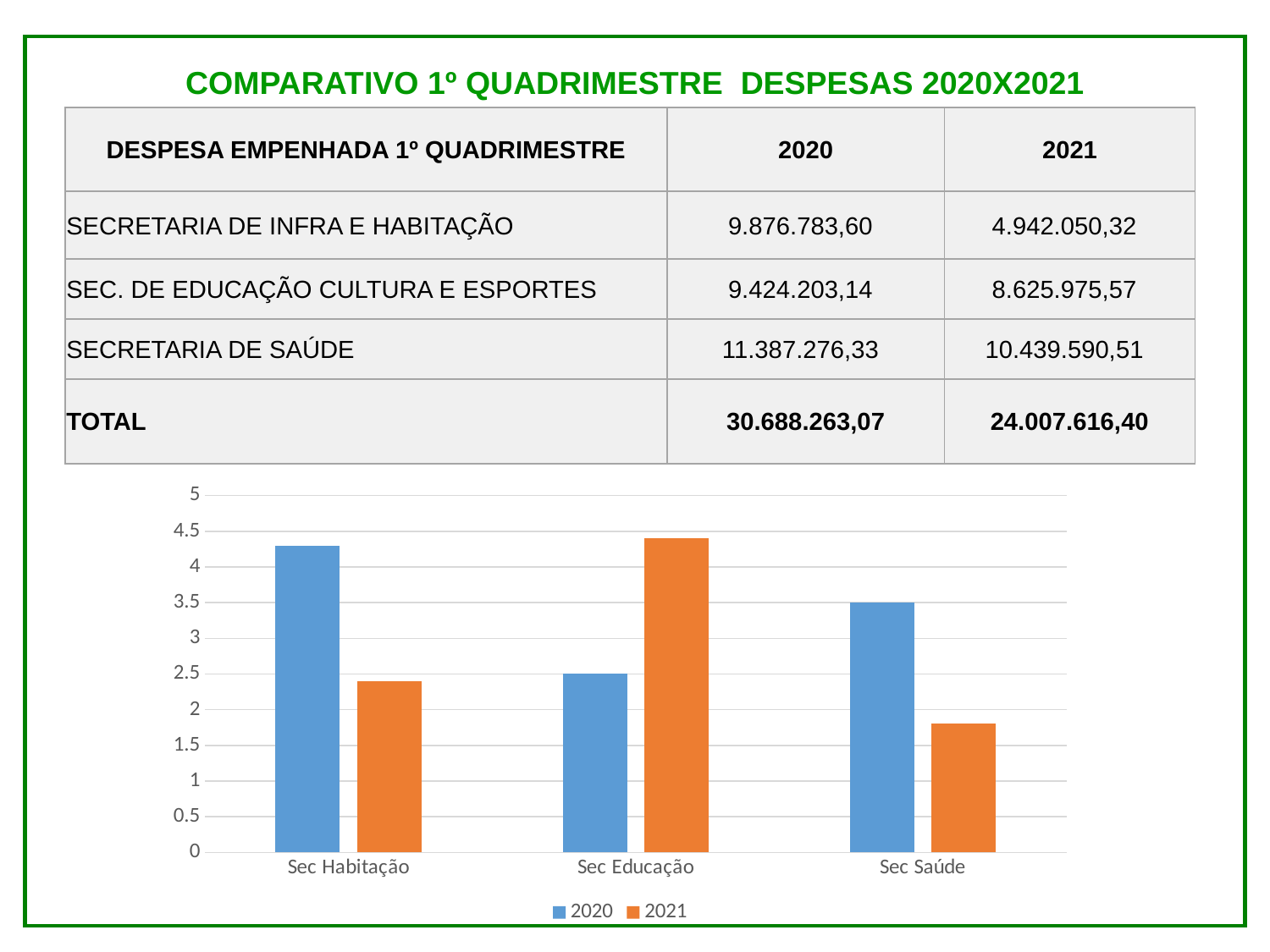
Which category has the highest value for the 2020 series? Sec Habitação What colour are the bars for the 2021 series in the chart? orange Is the 2021 value for Sec Educação greater or less than 4? greater How many series does the chart's legend list? 2 Which category has the lowest value for the 2021 series? Sec Saúde How many categories are shown on the x axis of the chart? 3 What kind of chart is shown on the slide? bar chart For Sec Habitação, which series has the larger value, 2020 or 2021? 2020 For Sec Educação, which series has the larger value, 2020 or 2021? 2021 Is the 2020 value for Sec Habitação greater or less than 4? greater Which category has the highest value for the 2021 series? Sec Educação Is the 2021 value for Sec Saúde greater or less than 2? less